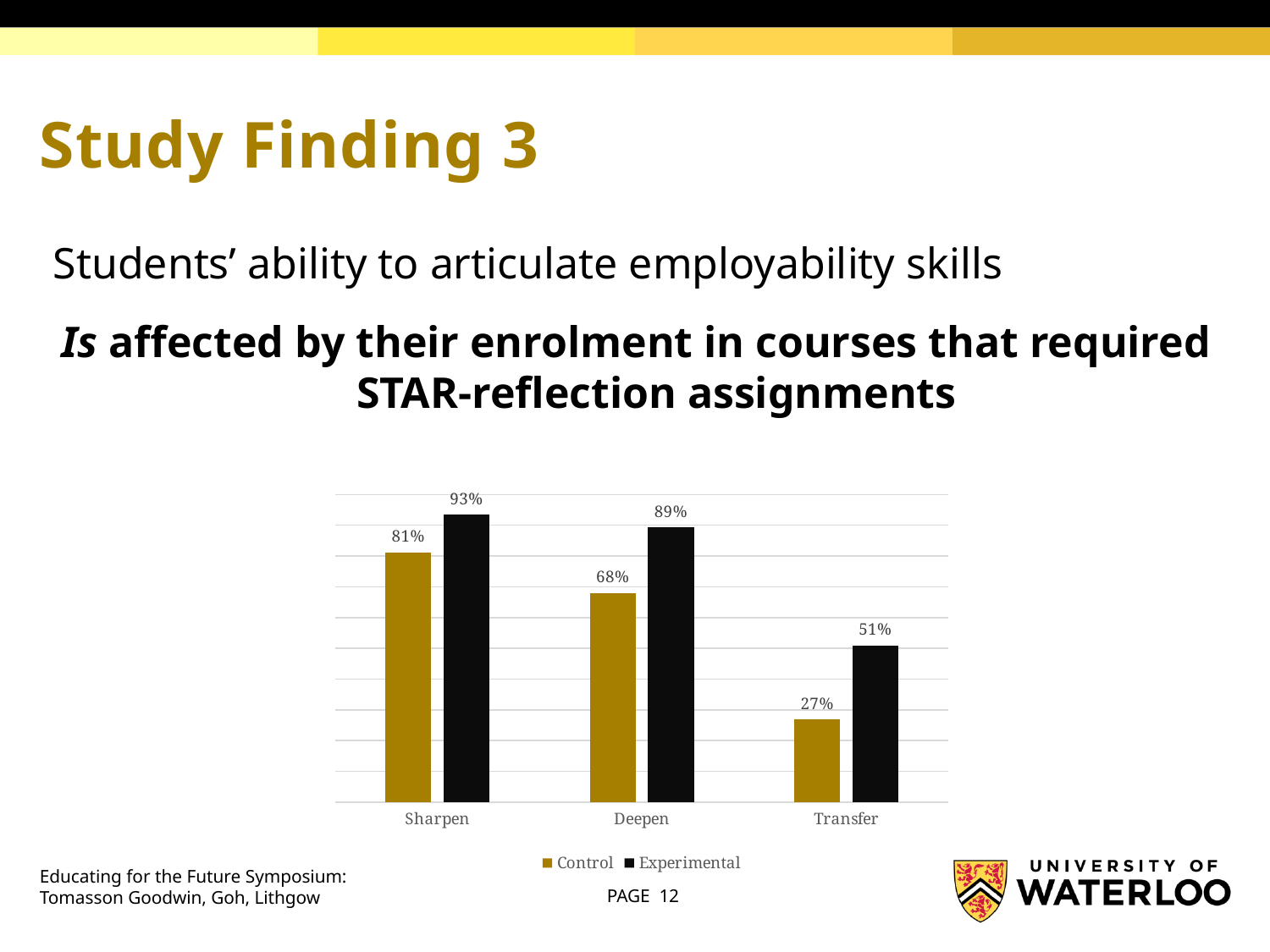
Which is larger for Transfer, the Control value or the Experimental value? Experimental What kind of chart is shown on the slide? Bar chart What is the Control value for Transfer? 27% What is the Experimental value for Deepen? 89% Which category has the highest Experimental value? Sharpen What is the Control value for Sharpen? 81% What is the difference between the Experimental and Control values for Deepen? 21% What is the Experimental value for Transfer? 51% Which category has the lowest Control value? Transfer How many series does the legend list? 2 How many categories are shown on the x axis? 3 Do the Control values rise or fall from Sharpen to Transfer? Fall